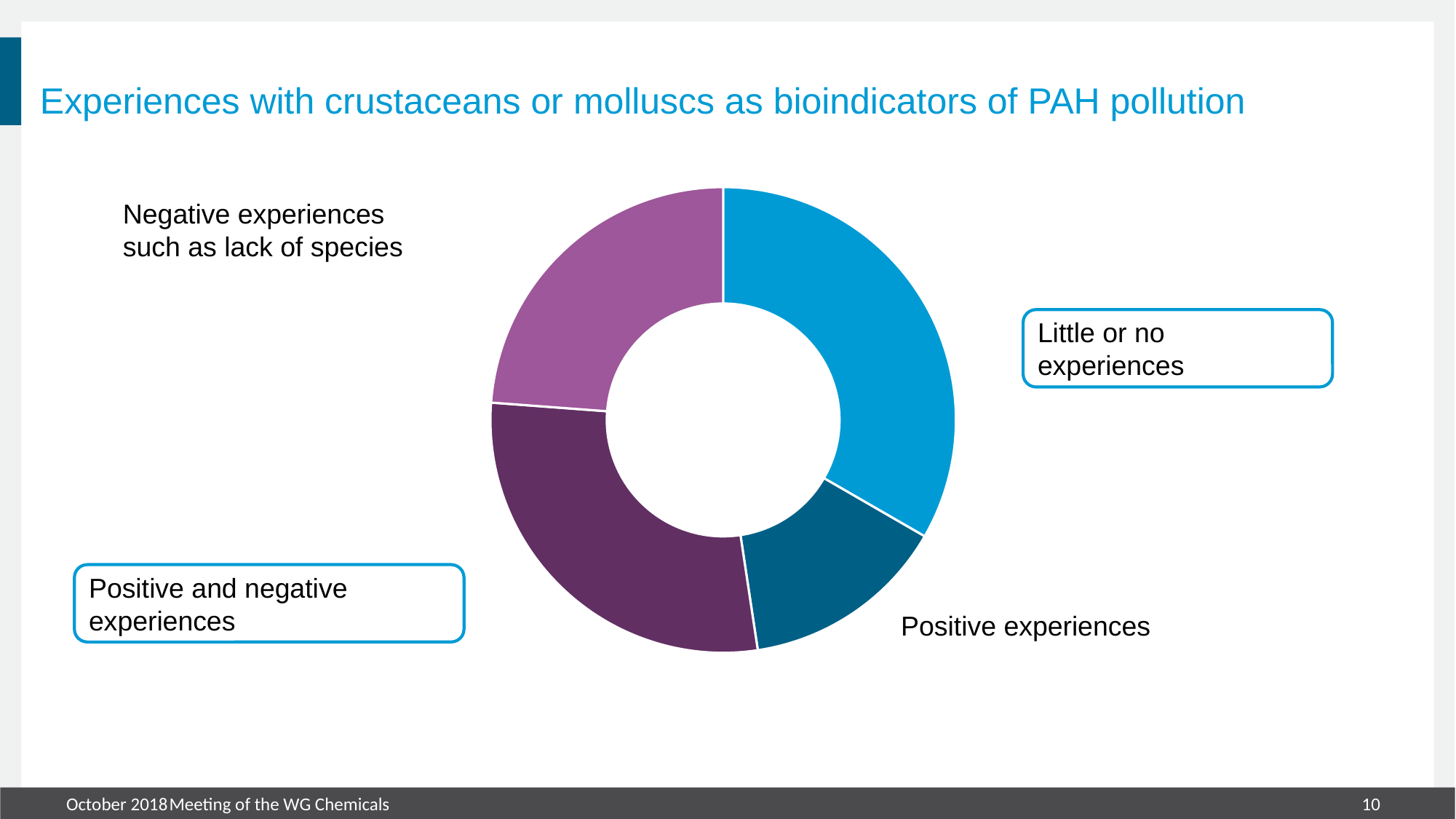
What kind of chart is shown on the slide? Doughnut (pie) chart What is the title of the slide containing the chart? Experiences with crustaceans or molluscs as bioindicators of PAH pollution Which category has the largest segment in the chart? Little or no experiences How many segments does the doughnut chart have? 4 Which segment is larger: "Little or no experiences" or "Negative experiences such as lack of species"? Little or no experiences Which segment is larger: "Negative experiences such as lack of species" or "Positive experiences"? Negative experiences such as lack of species Which category has the smallest segment in the chart? Positive experiences Which segment is larger: "Positive and negative experiences" or "Positive experiences"? Positive and negative experiences What colour is the segment labelled "Little or no experiences"? Light blue